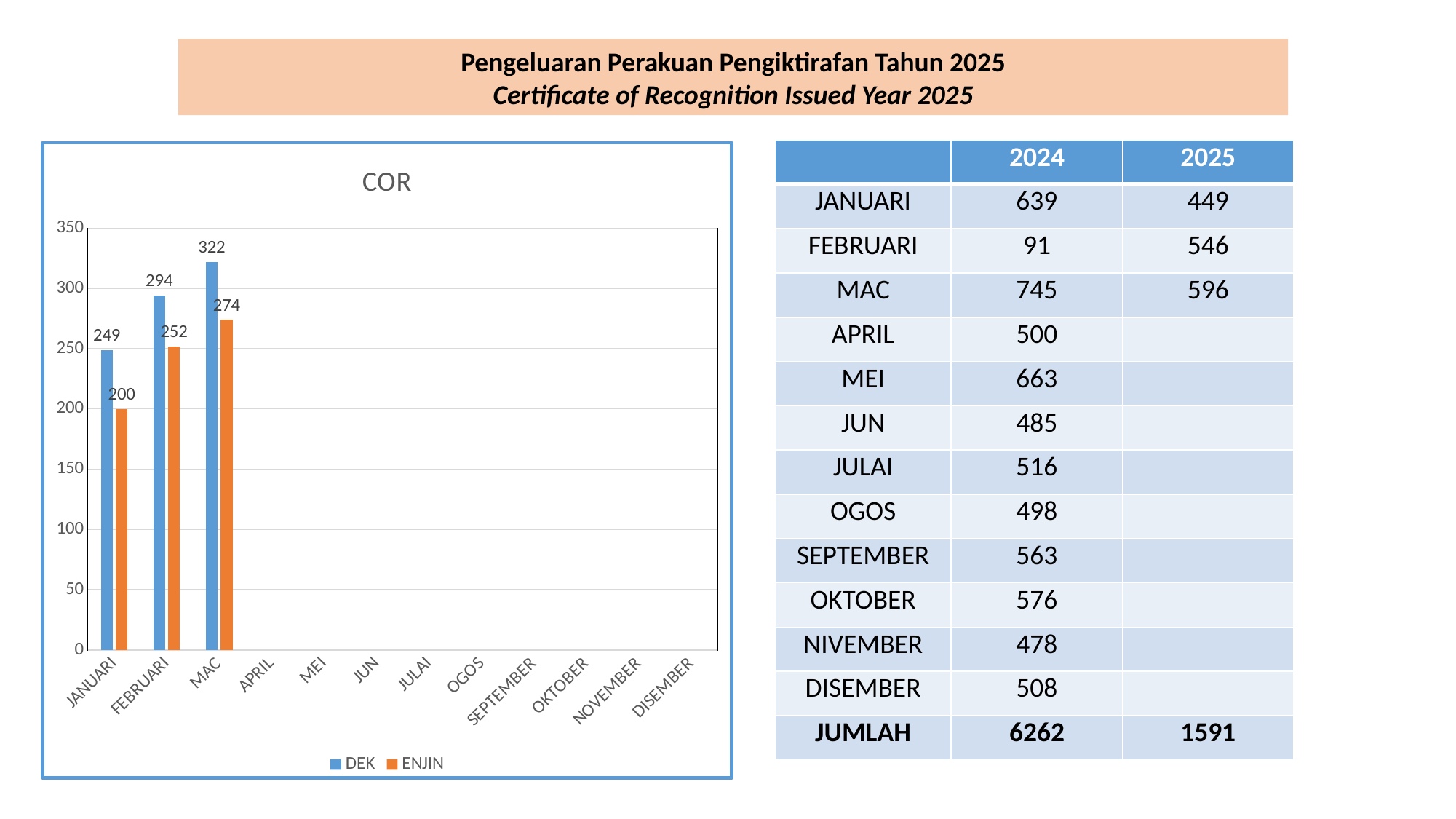
Which month has the lowest ENJIN value in the COR chart? JANUARI What is the ENJIN value for FEBRUARI in the COR chart? 252 What is the DEK value for JANUARI in the COR chart? 249 What kind of chart is the COR chart? bar chart How many month categories are shown on the x axis of the COR chart? 12 Do the DEK values rise or fall from JANUARI to MAC in the COR chart? rise What is the difference between the DEK values for MAC and FEBRUARI in the COR chart? 28 Which month has the highest DEK value in the COR chart? MAC In the COR chart, which is larger for FEBRUARI: DEK or ENJIN? DEK How many series does the legend of the COR chart list? 2 What is the difference between the DEK and ENJIN values for JANUARI in the COR chart? 49 What is the ENJIN value for MAC in the COR chart? 274